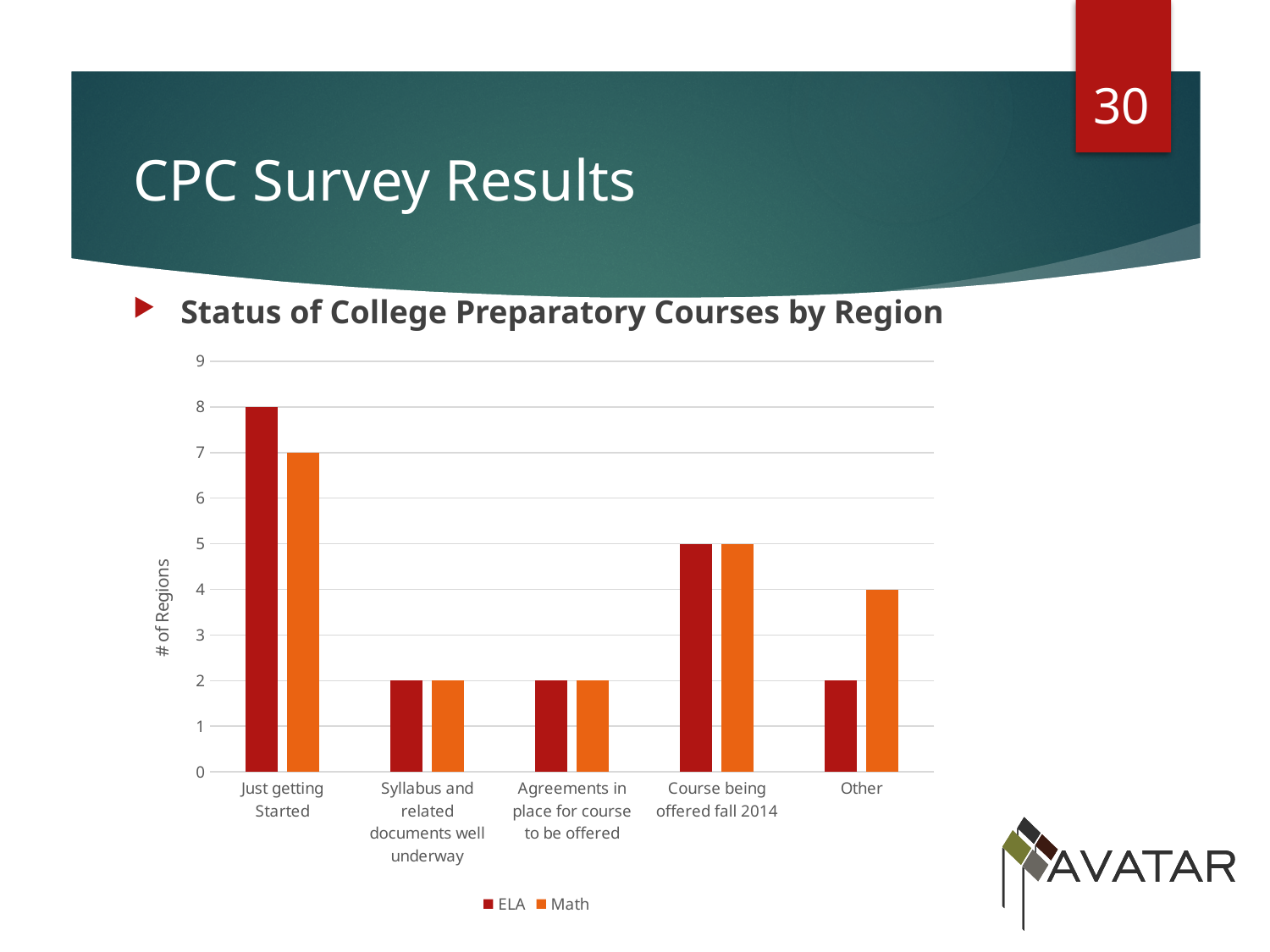
What is the Math value for Just getting Started? 7 For Other, which is larger, the ELA value or the Math value? Math What is the ELA value for Course being offered fall 2014? 5 What is the ELA value for Just getting Started? 8 What type of chart is shown on the slide? bar chart How many series does the legend list? 2 What is the difference between the ELA and Math values for Just getting Started? 1 What is the label of the y axis? # of Regions Which category has the highest ELA value? Just getting Started What is the difference between the Math value for Other and the ELA value for Other? 2 What is the Math value for Other? 4 How many categories are shown on the x axis? 5